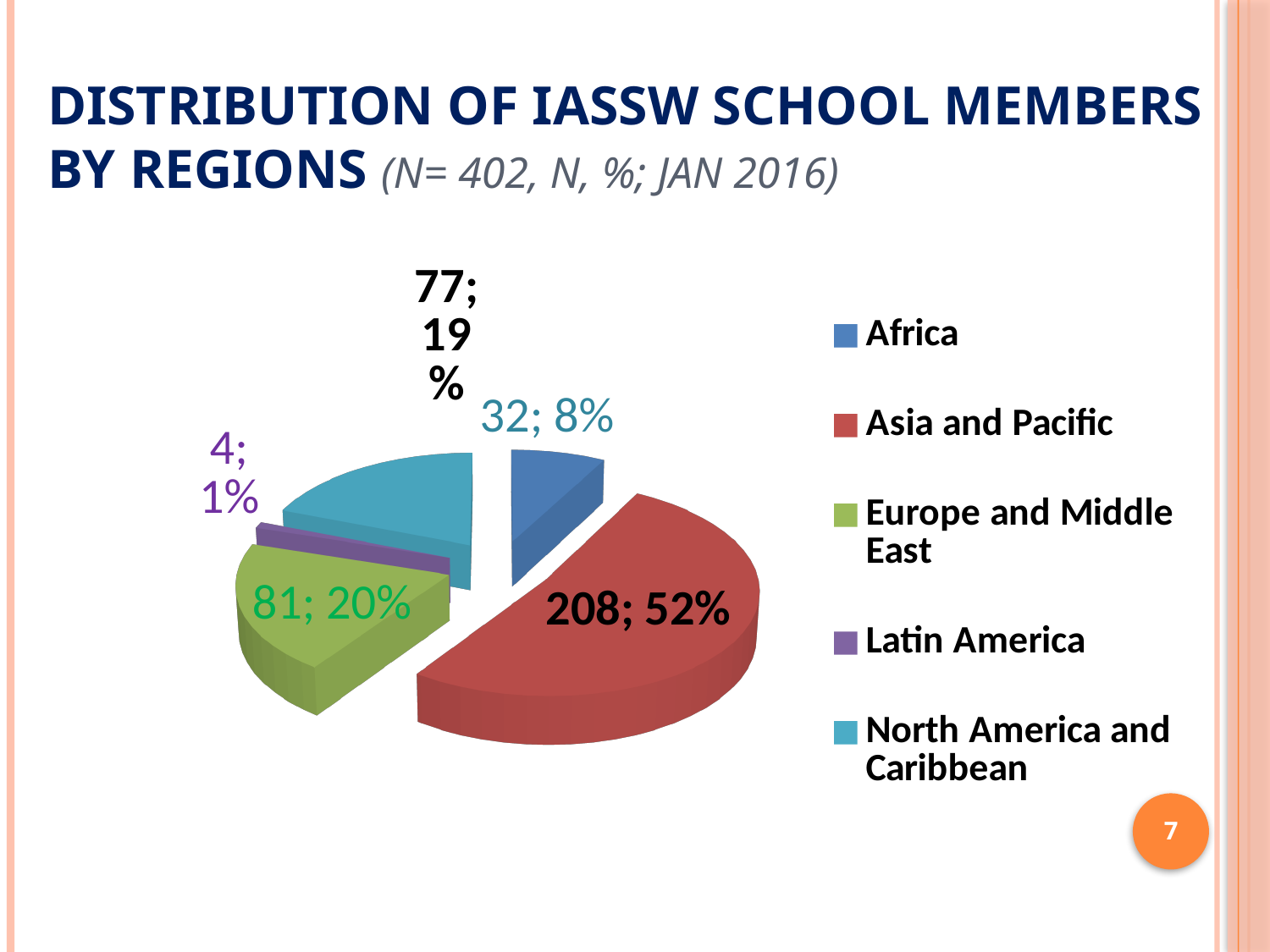
What is the difference in the number of members between Asia and Pacific and Europe and Middle East? 127 How many IASSW school members are in Asia and Pacific? 208 What percentage of IASSW school members are in Africa? 8% What colour is the slice for Europe and Middle East? green Which region has more members, North America and Caribbean or Africa? North America and Caribbean How many IASSW school members are in Latin America? 4 Which region has the largest share of IASSW school members? Asia and Pacific What kind of chart is shown on the slide? pie chart How many IASSW school members are in North America and Caribbean? 77 Which region has the smallest share of IASSW school members? Latin America How many regions are shown in the pie chart? 5 What percentage of IASSW school members are in Europe and Middle East? 20%